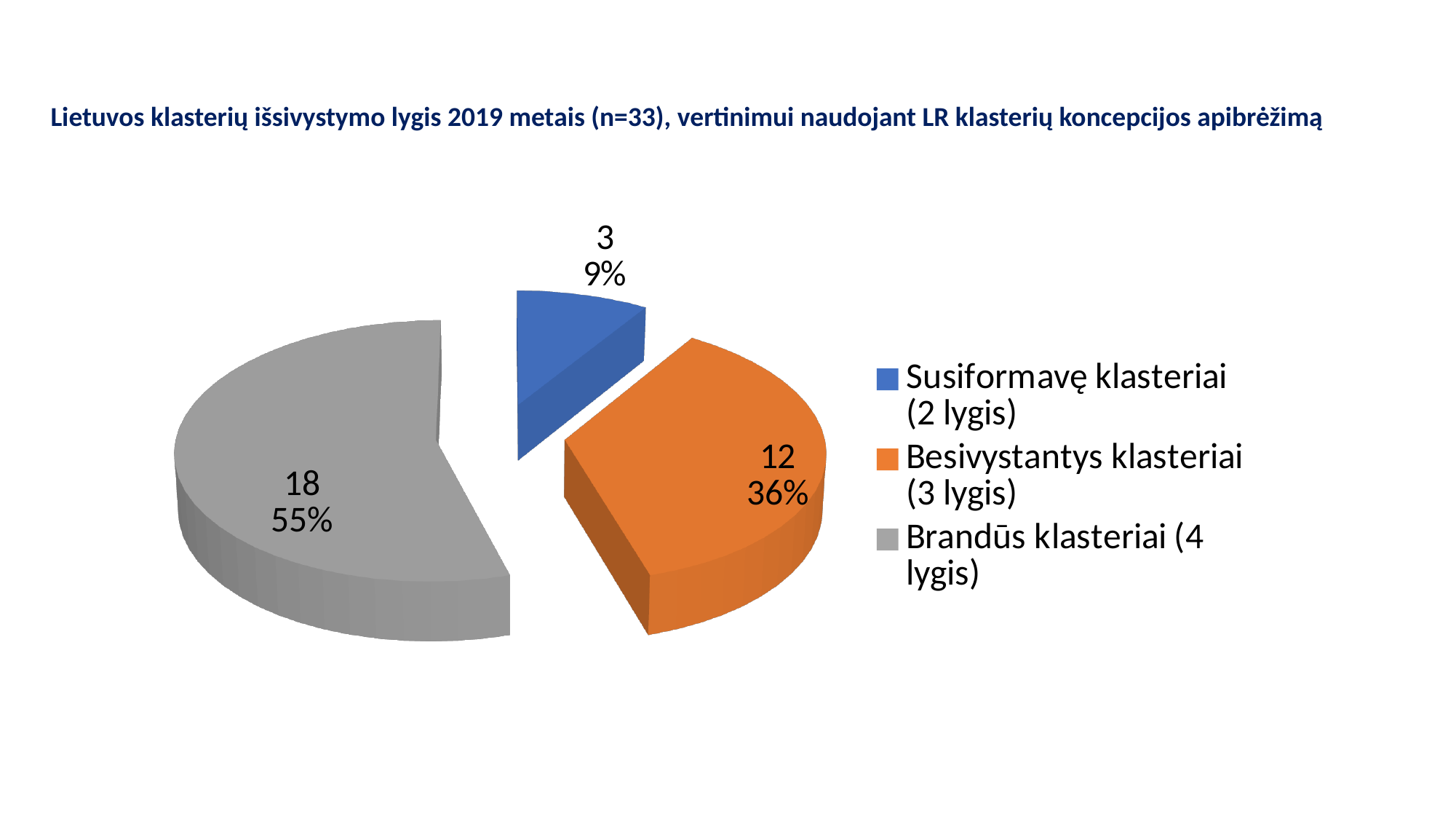
What is the value for Susiformavę klasteriai (2 lygis)? 3 How many slices does the pie chart have? 3 How many entries does the legend list? 3 Which colour represents Besivystantys klasteriai (3 lygis) in the chart? orange What is the difference between the values for Brandūs klasteriai (4 lygis) and Besivystantys klasteriai (3 lygis)? 6 What is the value for Brandūs klasteriai (4 lygis)? 18 Which category has the smallest slice? Susiformavę klasteriai (2 lygis) What kind of chart is shown on the slide? pie chart What share of the pie does Brandūs klasteriai (4 lygis) represent? 55% What share of the pie does Susiformavę klasteriai (2 lygis) represent? 9% What is the value for Besivystantys klasteriai (3 lygis)? 12 Which category has the largest slice? Brandūs klasteriai (4 lygis)